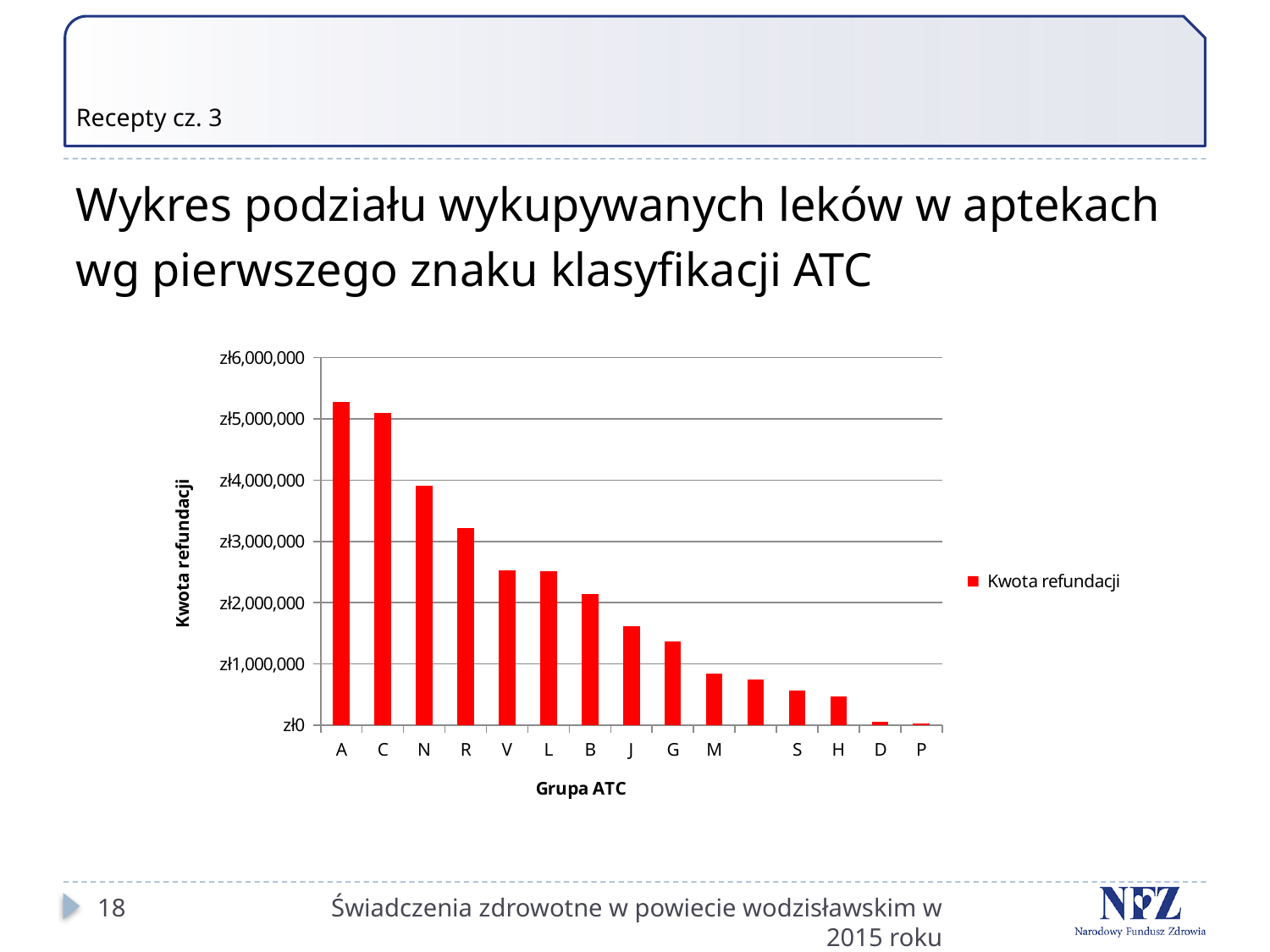
Do the values rise or fall moving from left to right along the x axis? fall Which has a larger refund amount, group N or group R? N Which ATC group has the highest refund amount (Kwota refundacji)? A Which has a larger refund amount, group J or group G? J Is the value for group R greater or less than zł3,000,000? greater Is the value for group J greater or less than zł2,000,000? less Is the value for group M greater or less than zł1,000,000? less How many series does the legend list? 1 What is the title of the x axis? Grupa ATC Which ATC group has the lowest refund amount? P What kind of chart is shown on the slide? bar chart